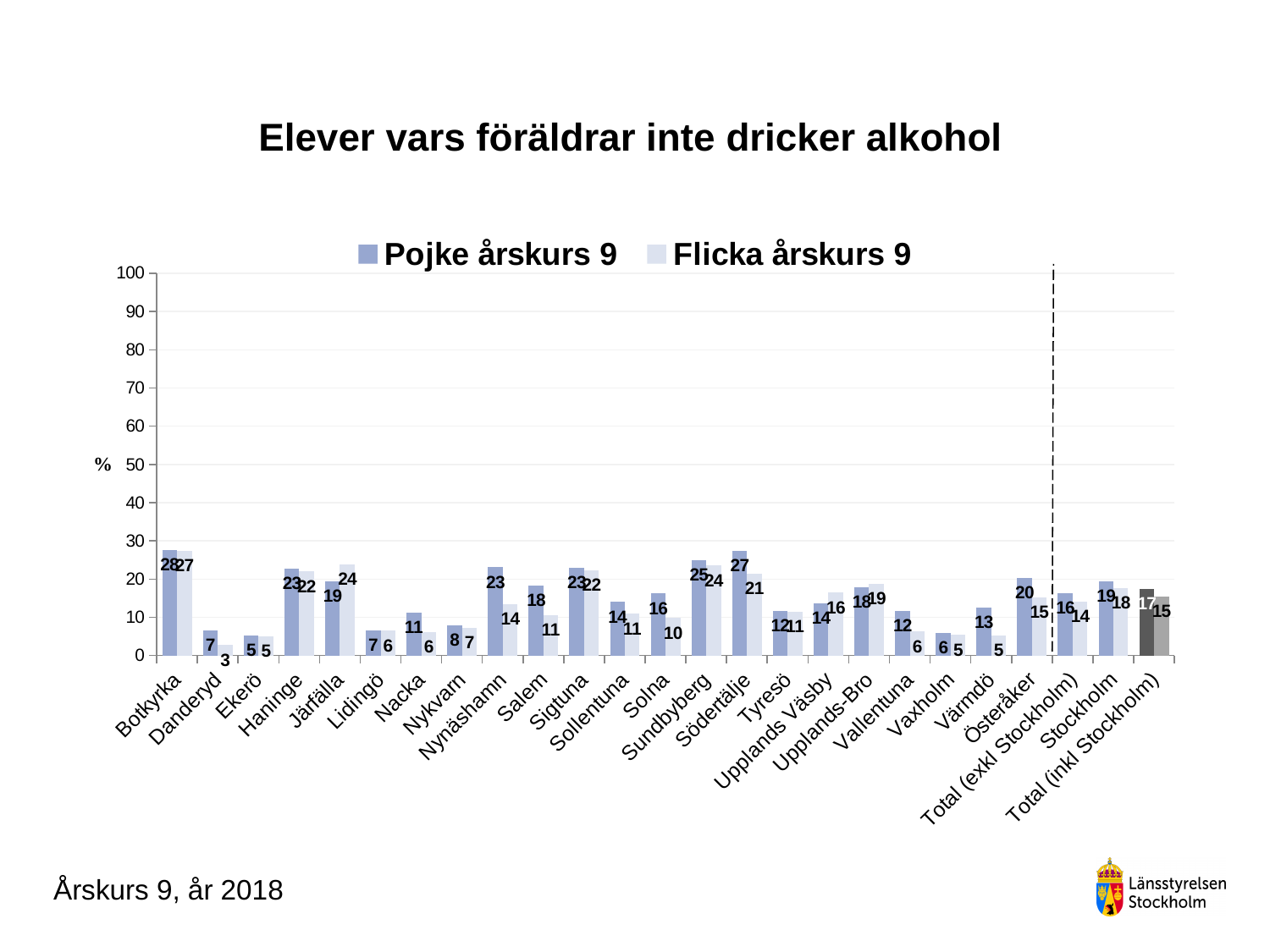
Which category has the lowest value for Flicka årskurs 9? Danderyd What kind of chart is shown on the slide? Bar chart Is the value for Pojke årskurs 9 in Södertälje greater or less than 20? greater How many categories are shown on the x axis? 25 Which municipality has the highest value for Pojke årskurs 9? Botkyrka Which is larger in Järfälla, the value for Pojke årskurs 9 or Flicka årskurs 9? Flicka årskurs 9 What is the difference between Pojke årskurs 9 and Flicka årskurs 9 in Nynäshamn? 9 What is the value for Pojke årskurs 9 in Botkyrka? 28 What is the value for Pojke årskurs 9 for Total (inkl Stockholm)? 17 What is the value for Flicka årskurs 9 in Järfälla? 24 What is the value for Flicka årskurs 9 in Danderyd? 3 How many series does the legend list? 2